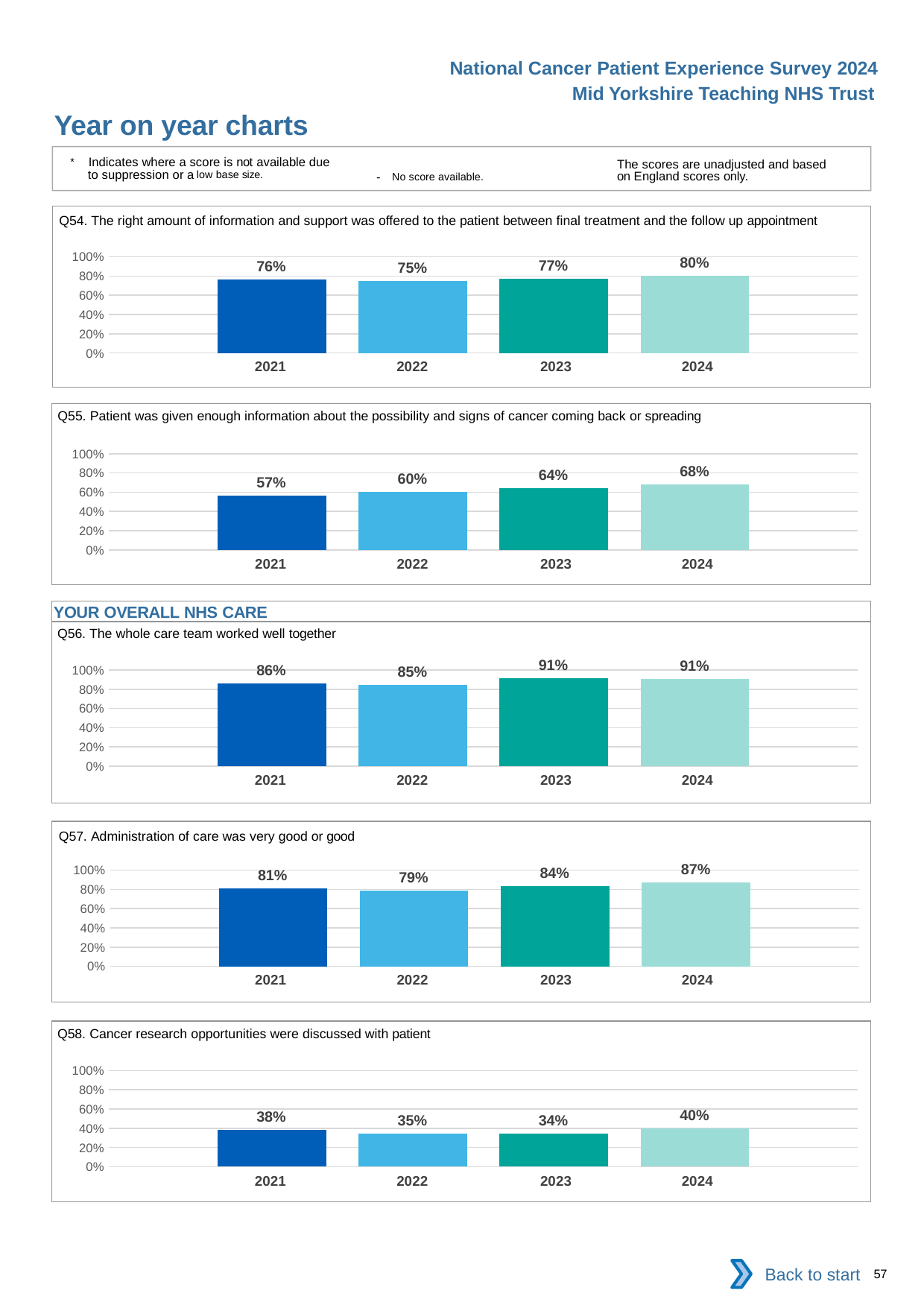
What kind of chart is the Q56 chart? bar chart In the Q54 chart, what is the value for 2024? 80% In the Q58 chart, what is the value for 2023? 34% In the Q56 chart, what is the value for 2022? 85% In the Q54 chart, what is the difference between the 2023 and 2022 values? 2 percentage points In the Q55 chart, what is the difference between the 2024 and 2021 values? 11 percentage points In the Q57 chart, which is larger, the value for 2021 or the value for 2022? 2021 In the Q58 chart, is the value for 2024 greater or less than 60%? less In the Q57 chart, which year has the highest value? 2024 In the Q55 chart, do the values rise or fall from 2021 to 2024? rise In the Q55 chart, which year has the lowest value? 2021 How many years are shown in the Q54 chart? 4